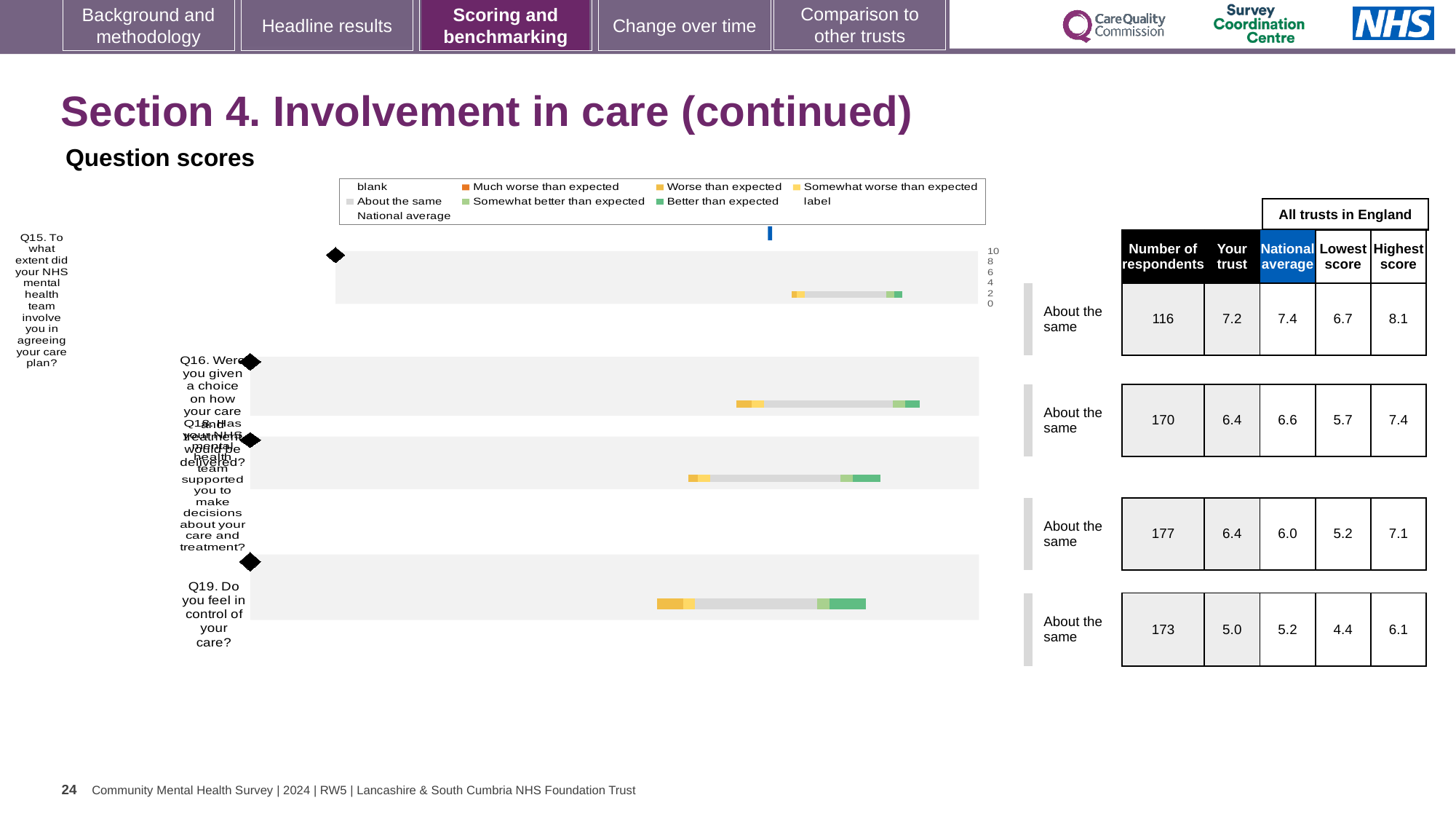
In the table beside the chart, what is the 'Your trust' score for Q19 (Do you feel in control of your care?)? 5.0 For Q18, is the 'Your trust' score or the national average larger in the table? Your trust What is the difference between the highest score and the lowest score for Q15 in the table? 1.4 In the table beside the chart, what is the national average for Q16? 6.6 Which question has the lowest 'Your trust' score in the table beside the chart? Q19 In the table beside the chart, how many respondents are listed for Q15? 116 In the table beside the chart, what is the highest score for Q18? 7.1 What benchmark category is shown for all four questions on this slide? About the same What kind of chart is used to show the question scores on this slide? bar chart How many questions (bars) are plotted in the question scores chart? 4 Which legend entry in the question scores chart is shown in orange? Much worse than expected Which question has the largest number of respondents in the table beside the chart? Q18